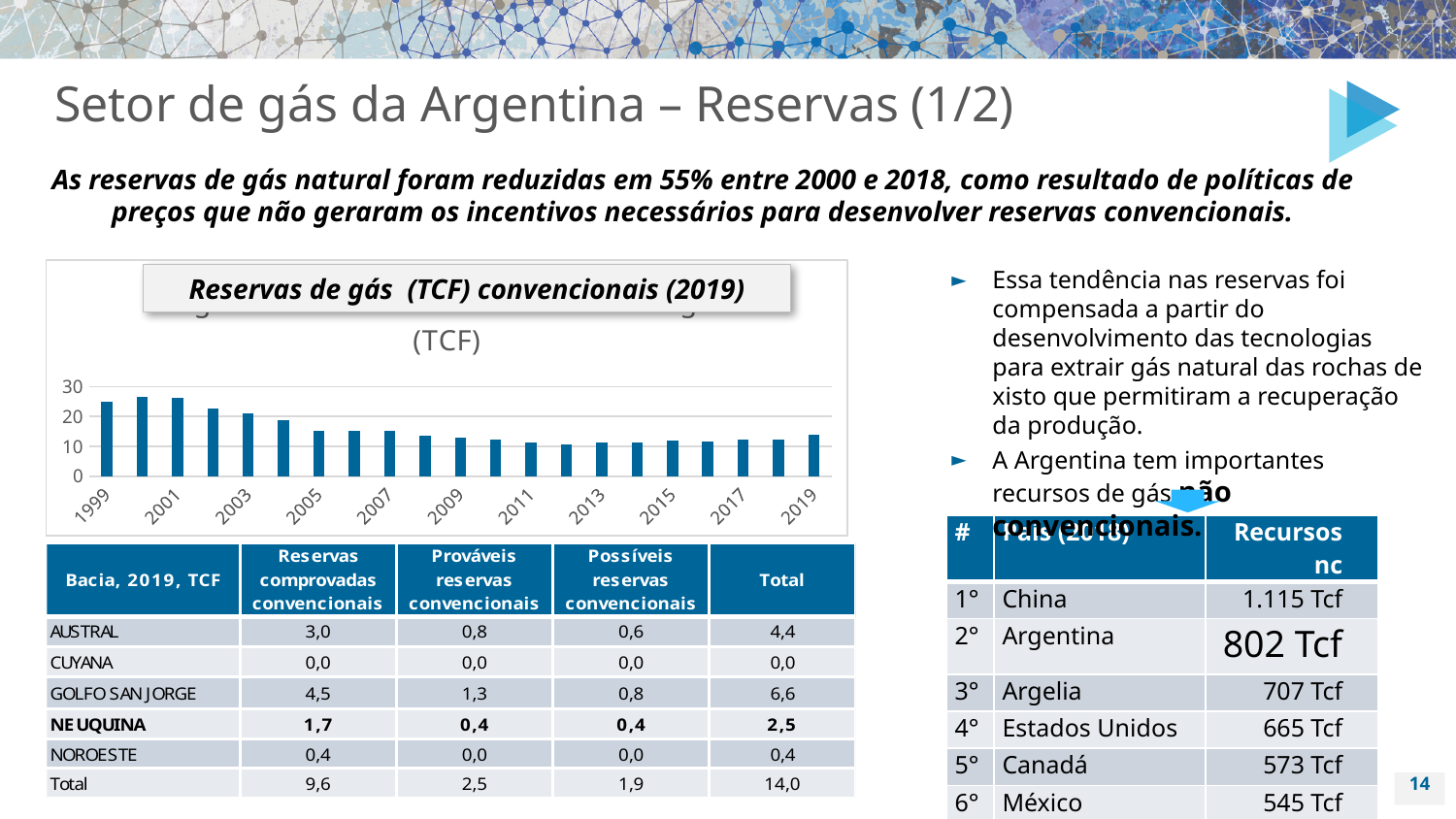
Is the value for 2001 greater or less than 20? greater Do the values generally rise or fall from 1999 to 2012? fall Which is larger, the value for 2003 or the value for 2009? 2003 What is the title shown above the chart? Reservas de gás (TCF) convencionais (2019) Is the value for 1999 greater or less than 20? greater What is the highest value shown on the vertical axis? 30 Is the value for 2019 greater or less than 20? less What unit is shown in parentheses under the chart title? TCF Which is larger, the value for 1999 or the value for 2019? 1999 What kind of chart is shown on the slide? bar chart